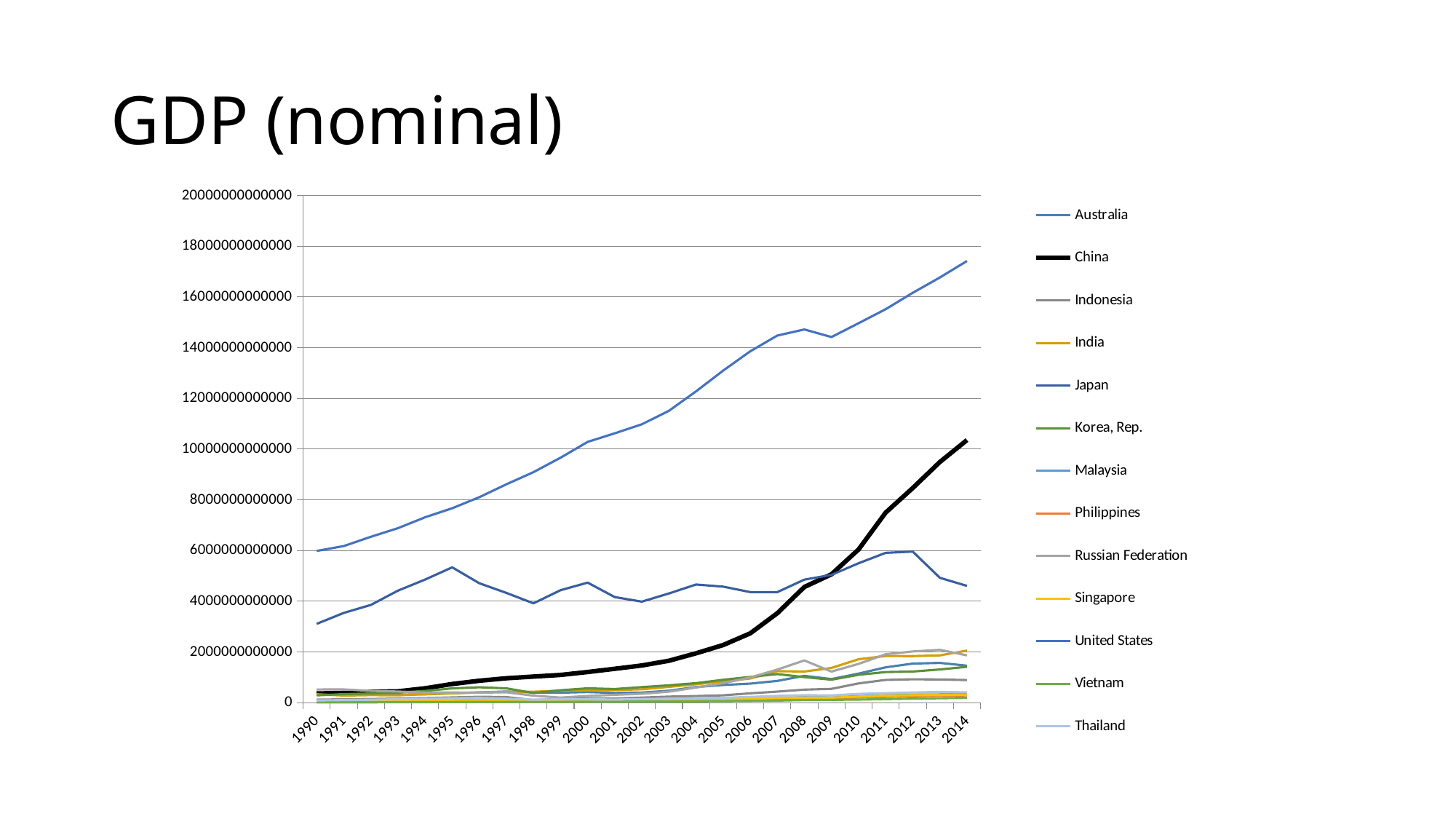
Which is larger in 2014, the value for China or the value for Japan? China Which series has the highest value in 2014? United States Does the United States line generally rise or fall from 1990 to 2014? rise Which series is drawn with the thick black line? China How many series does the legend list? 13 Is the value for United States in 2014 greater or less than 160000000000000? greater Is the value for United States in 1990 greater or less than 40000000000000? greater What kind of chart is shown on the slide? line chart Which is larger in 1990, the value for China or the value for Japan? Japan How many years are shown along the x axis? 25 Is the value for China in 2014 greater or less than 80000000000000? greater